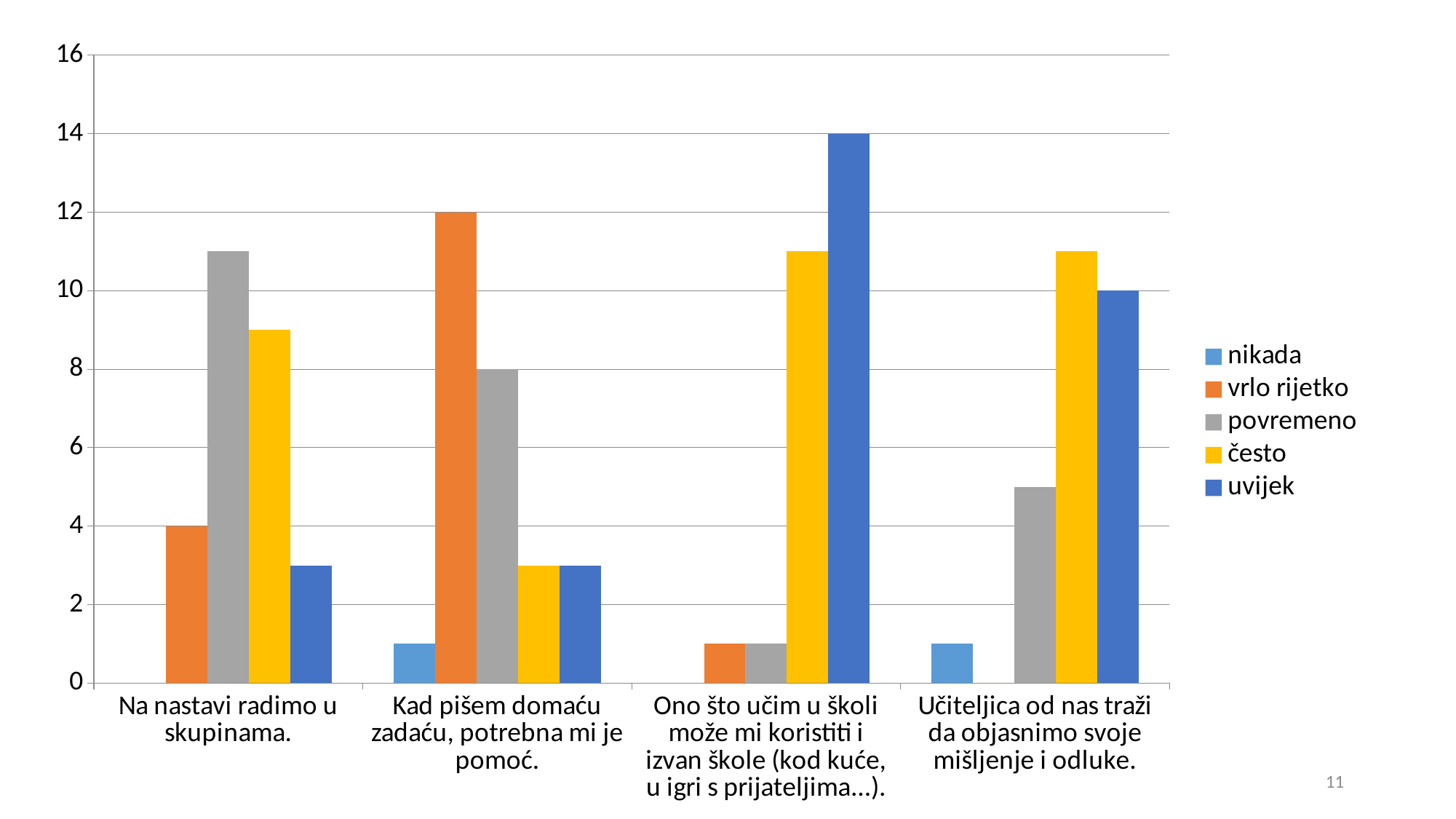
What is the value of 'povremeno' for 'Kad pišem domaću zadaću, potrebna mi je pomoć.'? 8 What kind of chart is shown on the slide? bar chart What is the difference between 'vrlo rijetko' and 'povremeno' for 'Kad pišem domaću zadaću, potrebna mi je pomoć.'? 4 Which is larger for 'Kad pišem domaću zadaću, potrebna mi je pomoć.': 'vrlo rijetko' or 'povremeno'? vrlo rijetko Is the value of 'često' for 'Ono što učim u školi može mi koristiti i izvan škole (kod kuće, u igri s prijateljima...).' greater or less than 10? greater Which series has the highest value for 'Na nastavi radimo u skupinama.'? povremeno How many categories are shown on the x axis? 4 How many series does the legend list? 5 What is the value of 'uvijek' for 'Ono što učim u školi može mi koristiti i izvan škole (kod kuće, u igri s prijateljima...).'? 14 What is the value of 'vrlo rijetko' for 'Kad pišem domaću zadaću, potrebna mi je pomoć.'? 12 What is the value of 'uvijek' for 'Učiteljica od nas traži da objasnimo svoje mišljenje i odluke.'? 10 What is the value of 'vrlo rijetko' for 'Na nastavi radimo u skupinama.'? 4